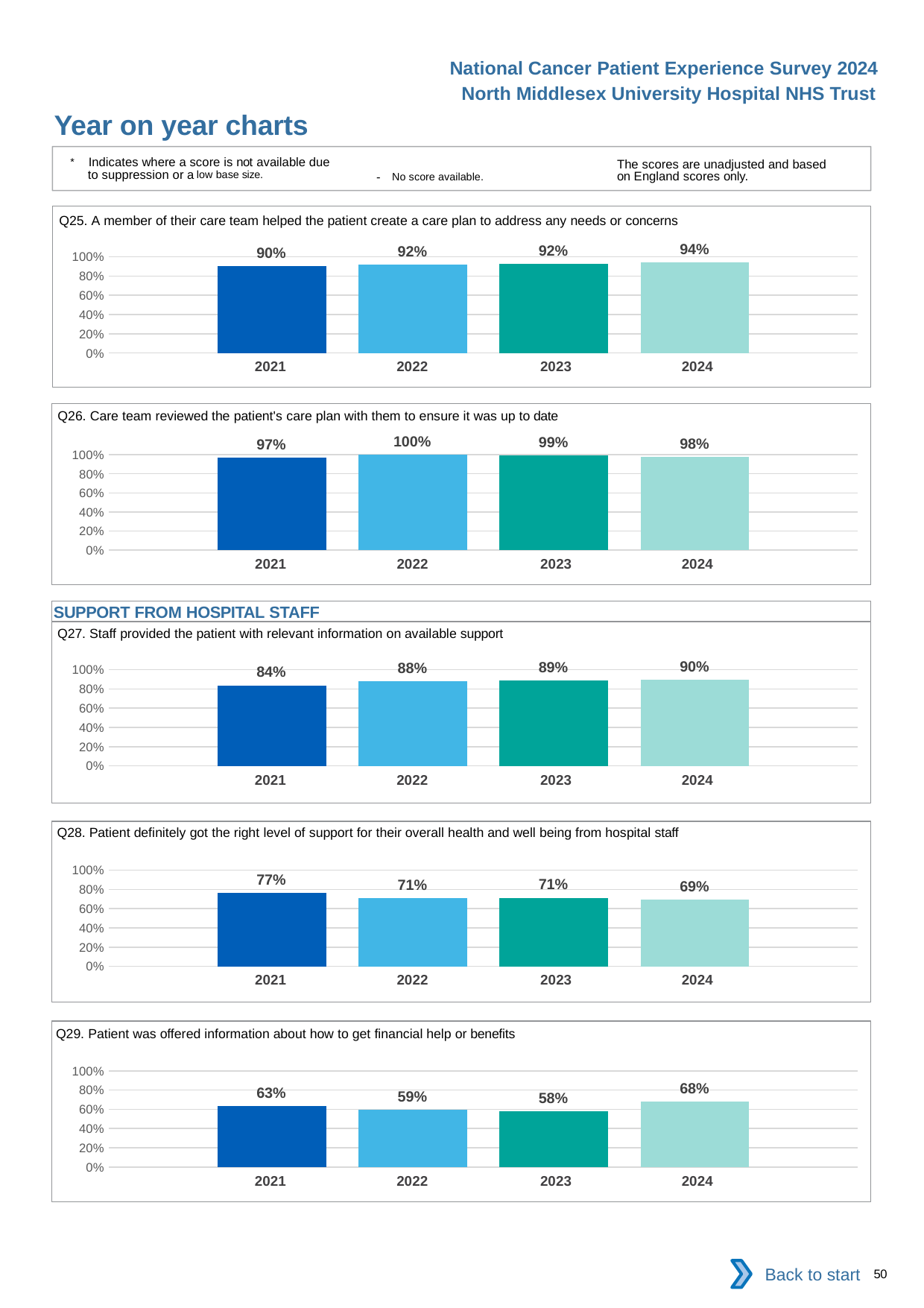
In the Q25 chart, what is the value for 2024? 94% In the Q28 chart, what is the value for 2022? 71% In the Q27 chart, what is the difference between the 2024 value and the 2021 value? 6% In the Q29 chart, which year has the lowest value? 2023 In the Q28 chart, which is larger, the value for 2021 or the value for 2024? 2021 In the Q29 chart, what is the difference between the 2024 value and the 2023 value? 10% How many years are shown on the x axis of the Q25 chart? 4 What kind of chart is the Q29 chart? Bar chart In the Q26 chart, what is the value for 2021? 97% In the Q26 chart, which year has the highest value? 2022 In the Q25 chart, do the values rise or fall from 2021 to 2024? Rise In the Q27 chart, which year has the lowest value? 2021